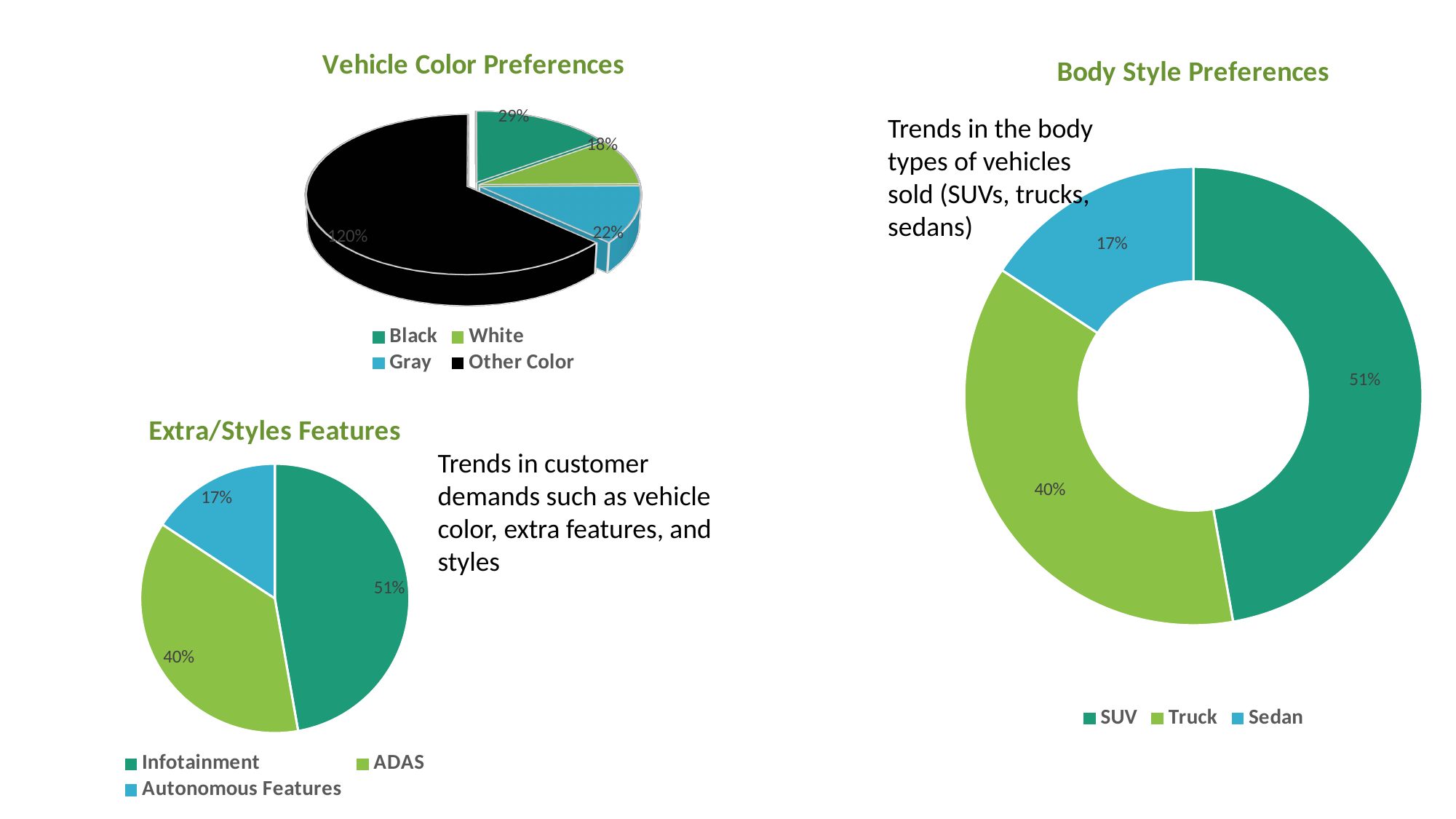
In the Body Style Preferences chart, what percentage is shown for Sedan? 17% In the Vehicle Color Preferences chart, which category has the largest slice? Other Color In the Extra/Styles Features chart, which is larger, Infotainment or Autonomous Features? Infotainment In the Body Style Preferences chart, what percentage is shown for Truck? 40% In the Extra/Styles Features chart, what percentage is shown for ADAS? 40% In the Vehicle Color Preferences chart, which category has the smallest slice? White In the Vehicle Color Preferences chart, what percentage is shown for Gray? 22% In the Body Style Preferences chart, what is the difference between the SUV and Truck percentages? 11% How many categories does the legend of the Vehicle Color Preferences chart list? 4 In the Body Style Preferences chart, which body style has the largest share? SUV What kind of chart is the Body Style Preferences chart? Doughnut chart In the Vehicle Color Preferences chart, what percentage is shown for White? 18%